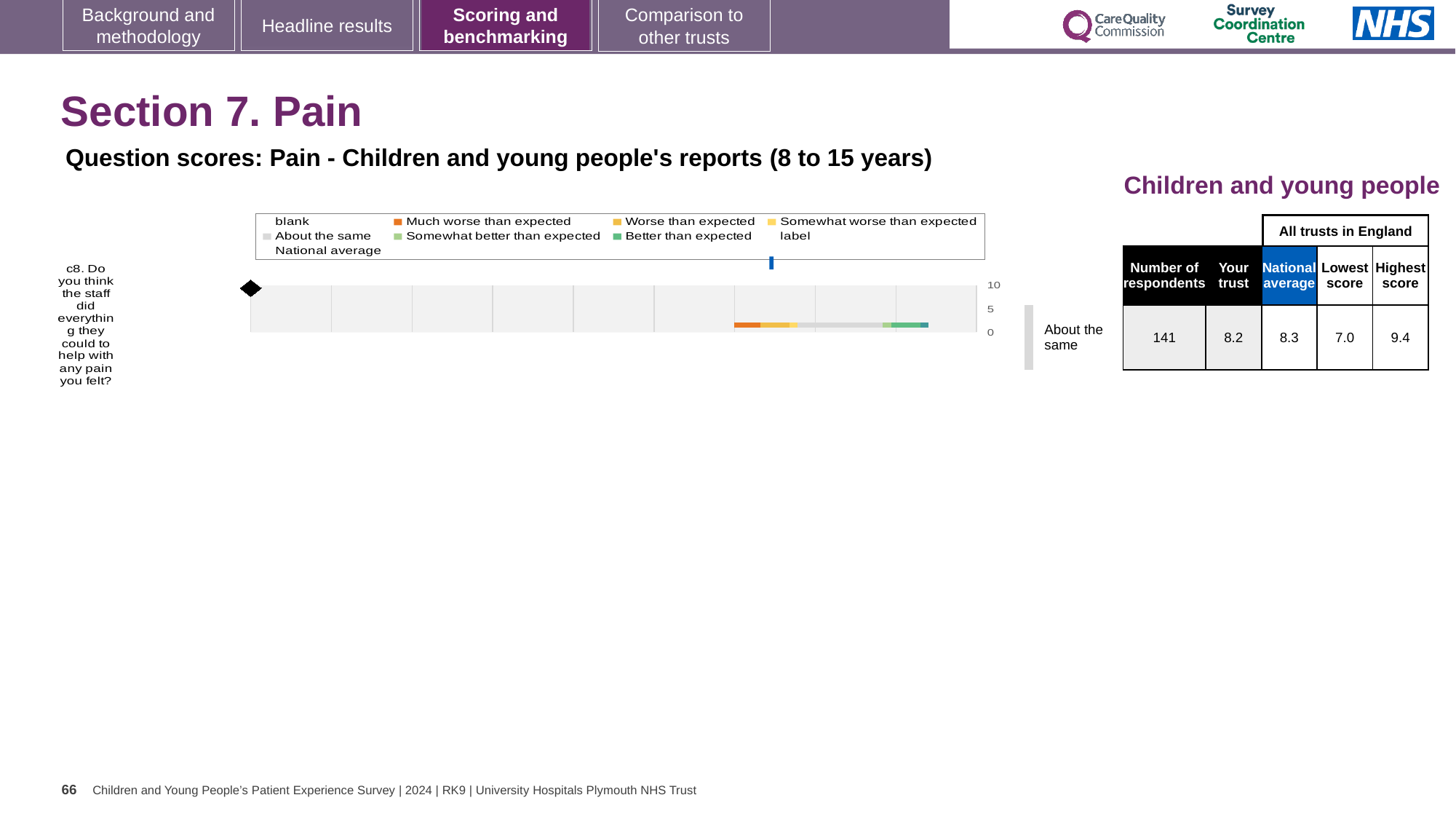
How many survey questions are plotted on the chart? 1 Which is larger for question c8: the 'Your trust' score or the national average? National average What is the difference between the highest score and the lowest score for question c8 in the table next to the chart? 2.4 According to the table next to the chart, what is the lowest score among all trusts in England for question c8? 7.0 According to the table next to the chart, what is the highest score among all trusts in England for question c8? 9.4 Which legend entry is shown in orange? Much worse than expected According to the table next to the chart, what is the national average score for question c8? 8.3 According to the table next to the chart, how many respondents answered question c8? 141 What kind of chart is shown on the slide? bar chart How many entries does the chart legend list? 9 According to the table next to the chart, what is the 'Your trust' score for question c8? 8.2 Which question is plotted on the chart? c8. Do you think the staff did everything they could to help with any pain you felt?